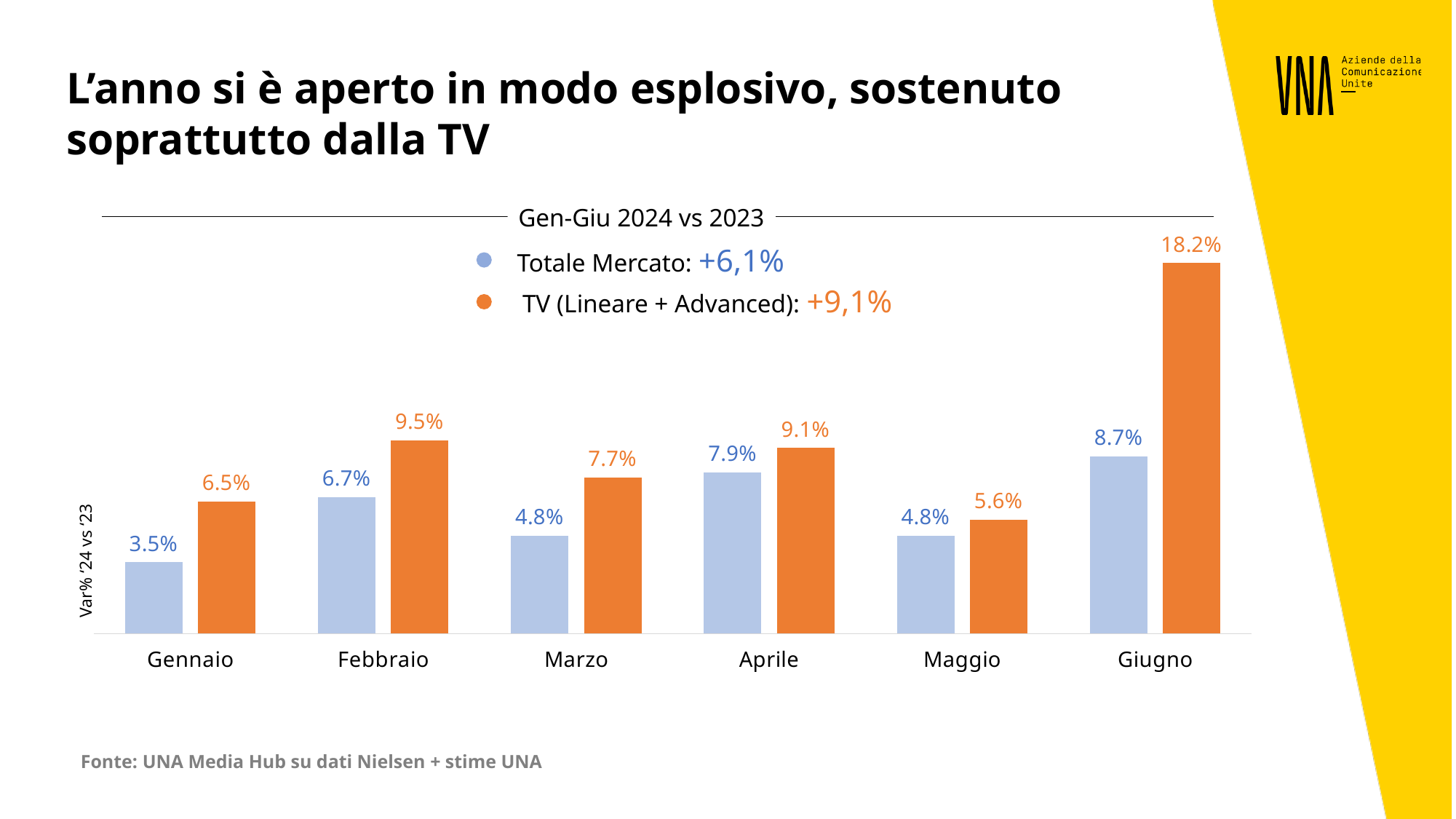
Which is larger, the Totale Mercato value for Febbraio or for Aprile? Aprile What is the TV (Lineare + Advanced) value for Marzo? 7.7% What kind of chart is shown on the slide? Bar chart How many months are shown on the x axis? 6 What is the overall Gen-Giu 2024 vs 2023 value for Totale Mercato shown in the legend? +6,1% Which month has the lowest Totale Mercato value? Gennaio Which month has the highest TV (Lineare + Advanced) value? Giugno What colour are the TV (Lineare + Advanced) bars? Orange What is the TV (Lineare + Advanced) value for Giugno? 18.2% What is the difference between the TV (Lineare + Advanced) and Totale Mercato values for Giugno? 9.5% What is the Totale Mercato value for Gennaio? 3.5% How many series does the legend list? 2